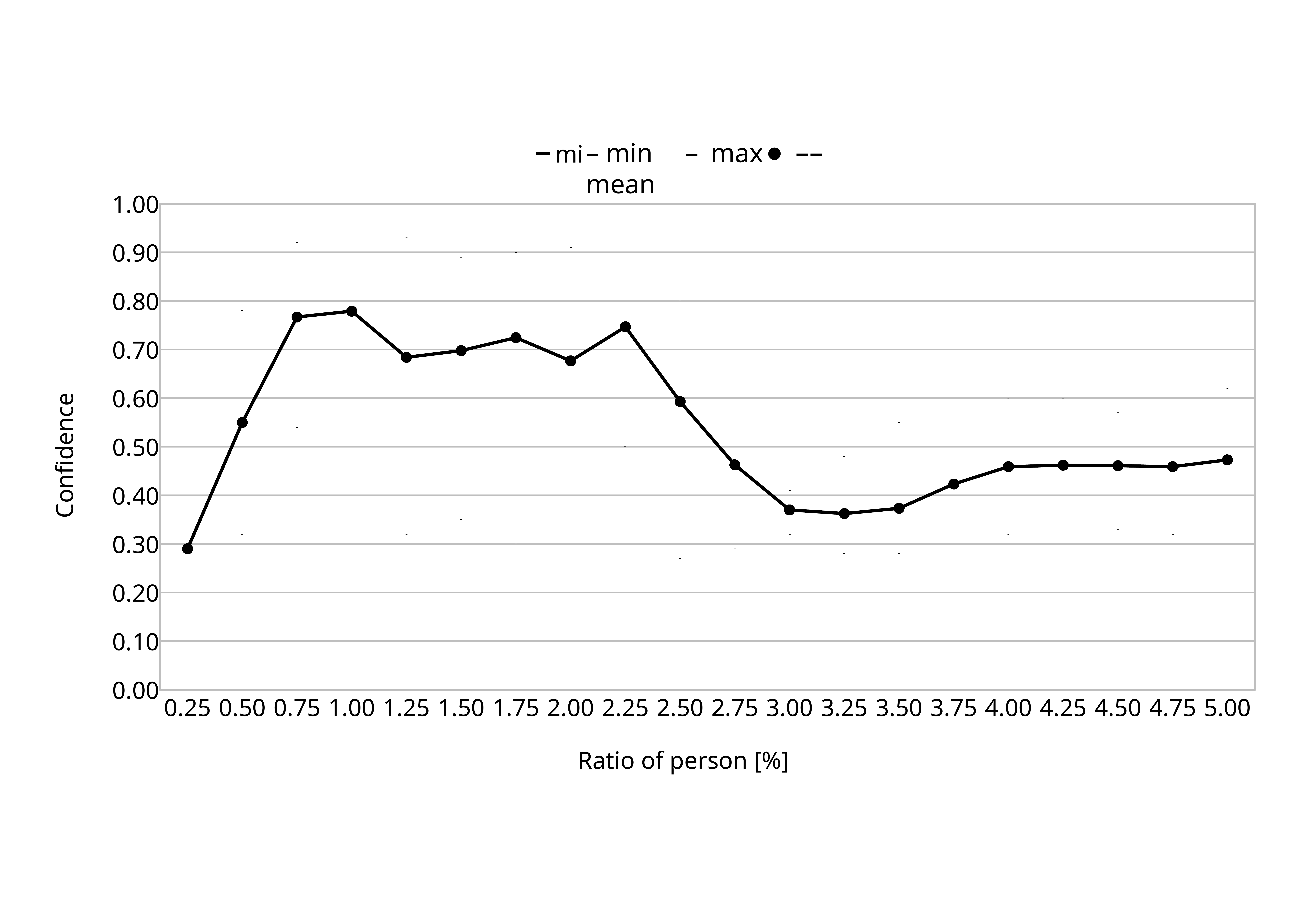
Does the mean confidence rise or fall between ratios of 2.25 and 3.25? fall Is the mean confidence at a ratio of 1.00 greater or less than 0.70? greater How many points are plotted along the x axis for the mean series? 20 Is the mean confidence at a ratio of 5.00 greater or less than 0.50? less Is the mean confidence at a ratio of 0.25 greater or less than 0.40? less What is the label of the y axis? Confidence At which ratio of person is the mean confidence lowest? 0.25 What is the label of the x axis? Ratio of person [%] Which has the higher mean confidence, a ratio of 0.75 or a ratio of 2.75? 0.75 What kind of chart is shown on the slide? line chart How many series does the legend list? 3